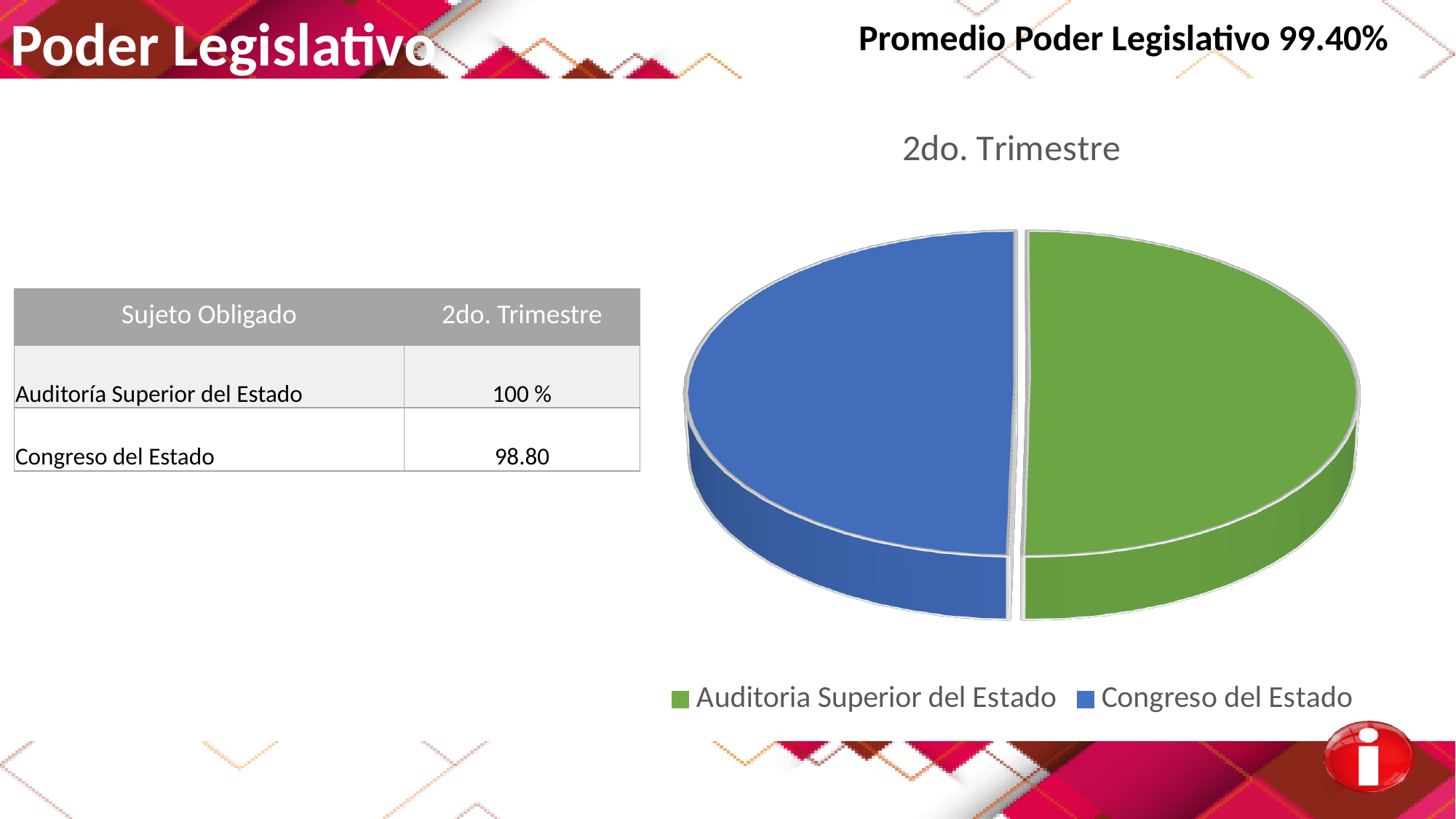
According to the table on the slide, what is the 2do. Trimestre value for Congreso del Estado? 98.80 Which colour represents Congreso del Estado in the pie chart? blue What is the Promedio Poder Legislativo value shown at the top of the slide? 99.40% What is the title of the pie chart? 2do. Trimestre What kind of chart is shown on the slide? pie chart How many slices does the pie chart have? 2 How many entries does the legend of the pie chart list? 2 Based on the values printed in the table, which has the larger 2do. Trimestre value: Auditoría Superior del Estado or Congreso del Estado? Auditoría Superior del Estado According to the table on the slide, what is the 2do. Trimestre value for Auditoría Superior del Estado? 100 %